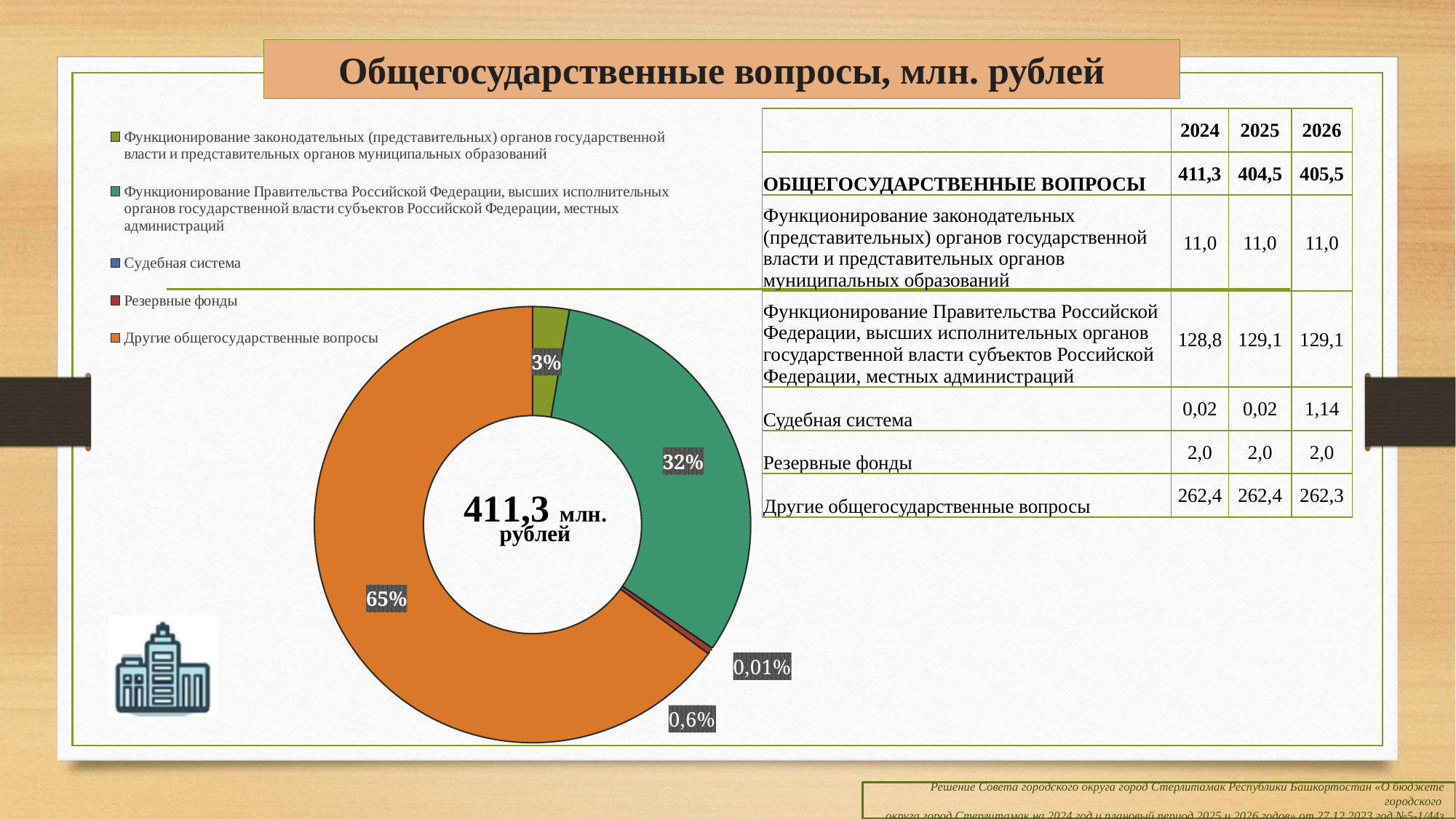
What share of the doughnut chart does "Другие общегосударственные вопросы" take? 65% What share of the doughnut chart does "Функционирование законодательных (представительных) органов государственной власти и представительных органов муниципальных образований" take? 3% What share of the doughnut chart does "Резервные фонды" take? 0,6% What total value is printed in the centre of the doughnut chart? 411,3 млн. рублей Which category has the largest slice in the doughnut chart? Другие общегосударственные вопросы How many categories does the doughnut chart's legend list? 5 What kind of chart is shown on the slide? Doughnut (pie) chart Which category has the smallest slice in the doughnut chart? Судебная система What colour is the slice for "Другие общегосударственные вопросы" in the doughnut chart? Orange Which slice is larger in the doughnut chart: "Резервные фонды" or "Судебная система"? Резервные фонды